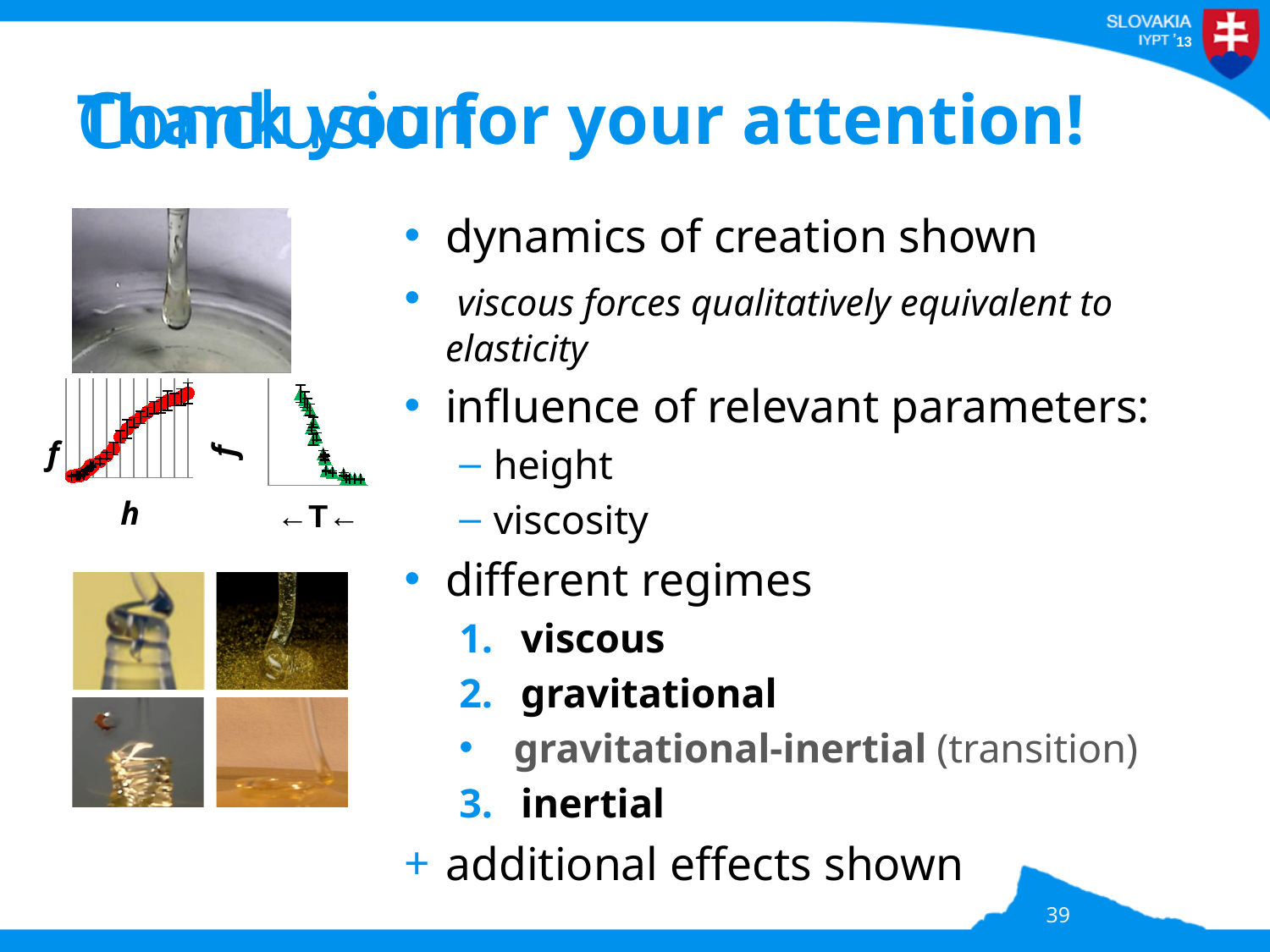
What kind of chart is the left chart with the red markers (f versus h)? scatter plot What colour are the data markers in the right chart (f versus T)? green In the left chart (f versus h), do the values of f rise or fall from left to right along the x axis? rise In the right chart (f versus T), do the values of f rise or fall from left to right along the x axis? fall What is the label on the horizontal axis of the left chart with the red markers? h What kind of chart is the right chart with the green markers (f versus T)? scatter plot